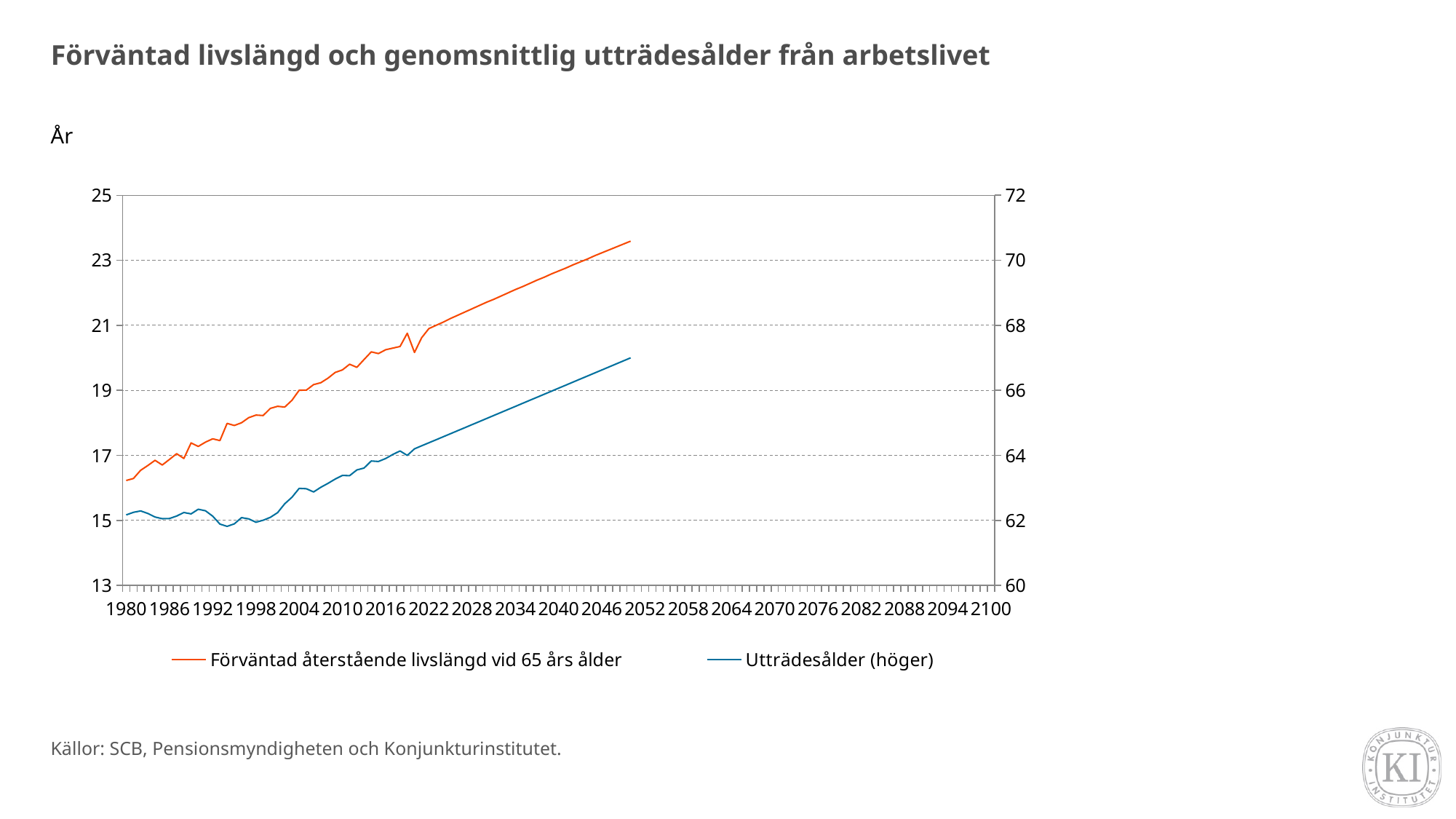
Is the value for 'Förväntad återstående livslängd vid 65 års ålder' in 2022 greater or less than 19? greater What is the title of the chart? Förväntad livslängd och genomsnittlig utträdesålder från arbetslivet Is the value for 'Utträdesålder (höger)' in 1980 greater or less than 64 on the right axis? less How many series does the legend list? 2 Which series is plotted against the right-hand axis? Utträdesålder (höger) What kind of chart is shown on the slide? line chart What is the first year shown on the x axis? 1980 Is the value for 'Utträdesålder (höger)' at the end of the series (around 2050) greater or less than 66 on the right axis? greater Does the series 'Förväntad återstående livslängd vid 65 års ålder' rise or fall from 1980 to 2050? rise Does the series 'Utträdesålder (höger)' rise or fall from 2000 to 2050? rise